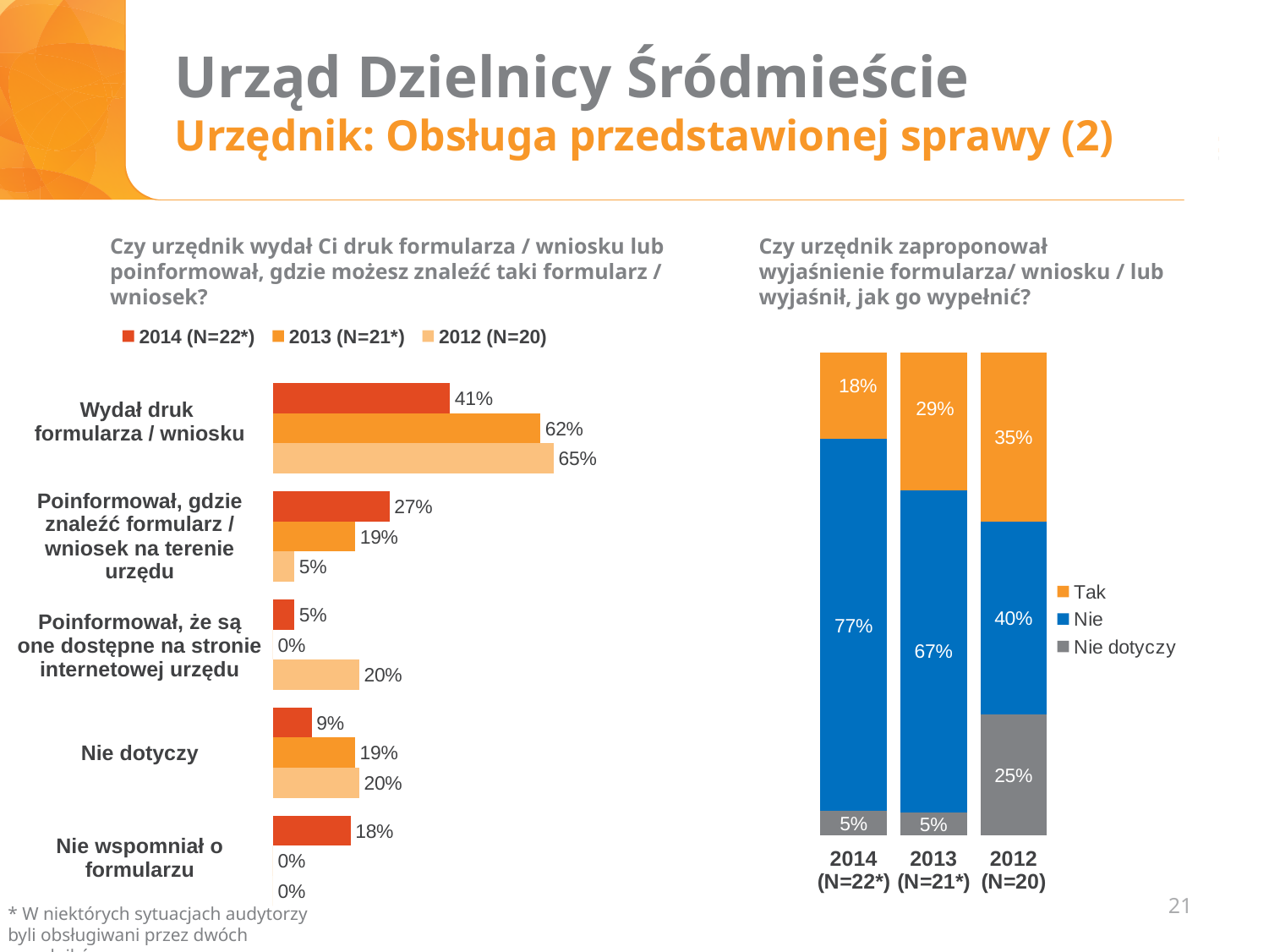
How many categories are shown in the left chart? 5 What kind of chart is the left chart? Bar chart In the left chart, what is the 2014 (N=22*) value for 'Wydał druk formularza / wniosku'? 41% In the left chart, what is the difference between the 2012 (N=20) and 2014 (N=22*) values for 'Wydał druk formularza / wniosku'? 24% In the right chart, what is the 'Nie' value for 2013 (N=21*)? 67% In the left chart, what is the 2012 (N=20) value for 'Poinformował, że są one dostępne na stronie internetowej urzędu'? 20% In the right chart, what is the difference between the 'Nie dotyczy' values for 2012 (N=20) and 2014 (N=22*)? 20% How many series does the legend of the left chart list? 3 In the left chart, which category has the highest 2013 (N=21*) value? Wydał druk formularza / wniosku In the left chart, which is larger for 'Poinformował, gdzie znaleźć formularz / wniosek na terenie urzędu': the 2014 (N=22*) value or the 2013 (N=21*) value? 2014 (N=22*) In the right chart, how do the 'Nie' values change from 2014 to 2012 along the x axis? They fall In the right chart, which year has the highest 'Tak' value? 2012 (N=20)